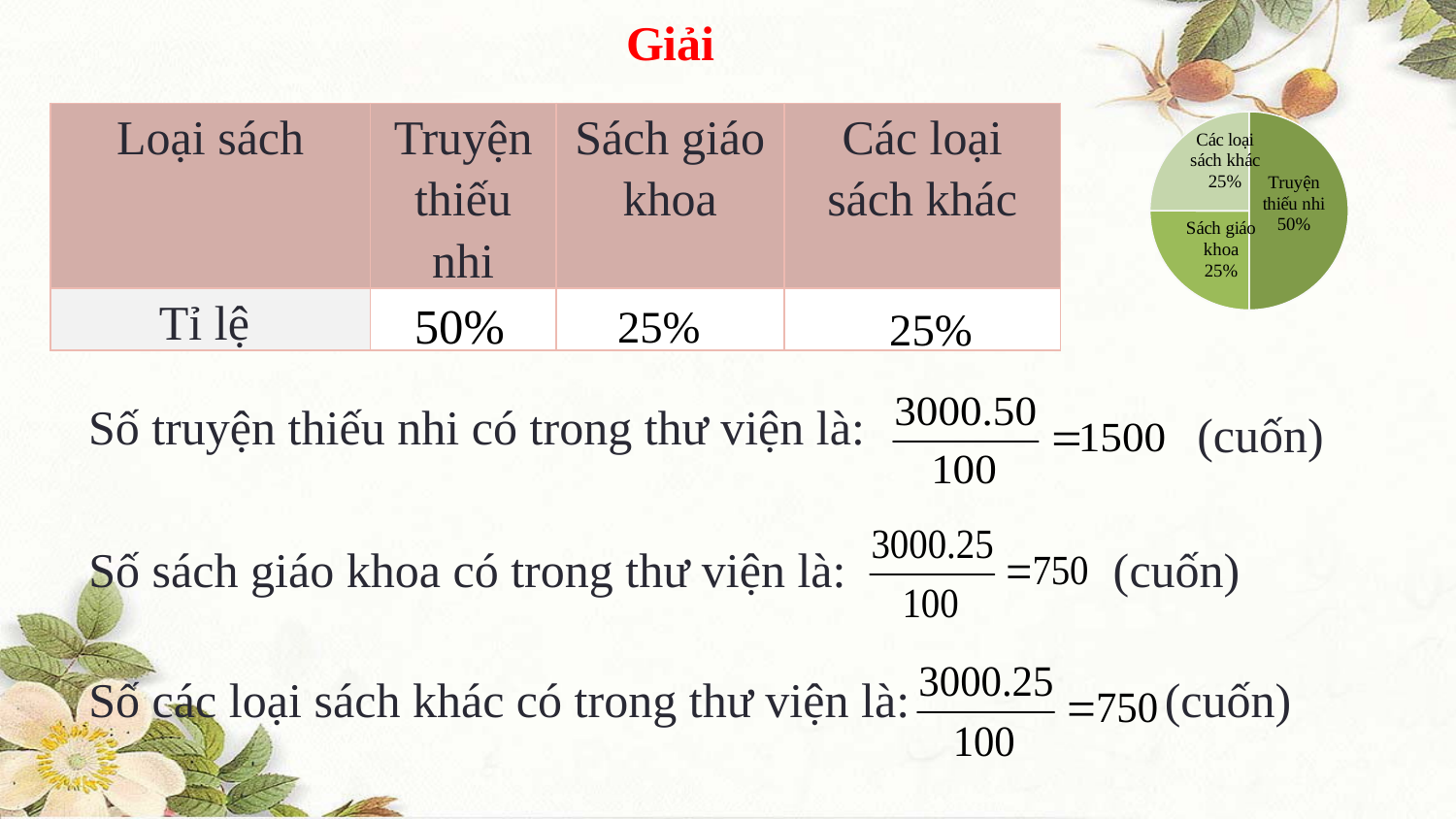
Which category has the largest slice in the pie chart? Truyện thiếu nhi What share of the pie chart is labelled for Sách giáo khoa? 25% Is the share for Sách giáo khoa in the pie chart greater or less than 30%? less How many slices does the pie chart have? 3 What kind of chart is shown on the slide? pie chart Do the slices for Sách giáo khoa and Các loại sách khác in the pie chart have the same share? Yes What is the difference between the shares of Truyện thiếu nhi and Các loại sách khác in the pie chart? 25% What share of the pie chart is labelled for Truyện thiếu nhi? 50% Where is the pie chart positioned on the slide? top right What share of the pie chart is labelled for Các loại sách khác? 25% Which is larger in the pie chart, Truyện thiếu nhi or Sách giáo khoa? Truyện thiếu nhi Is the share for Truyện thiếu nhi in the pie chart greater or less than 40%? greater